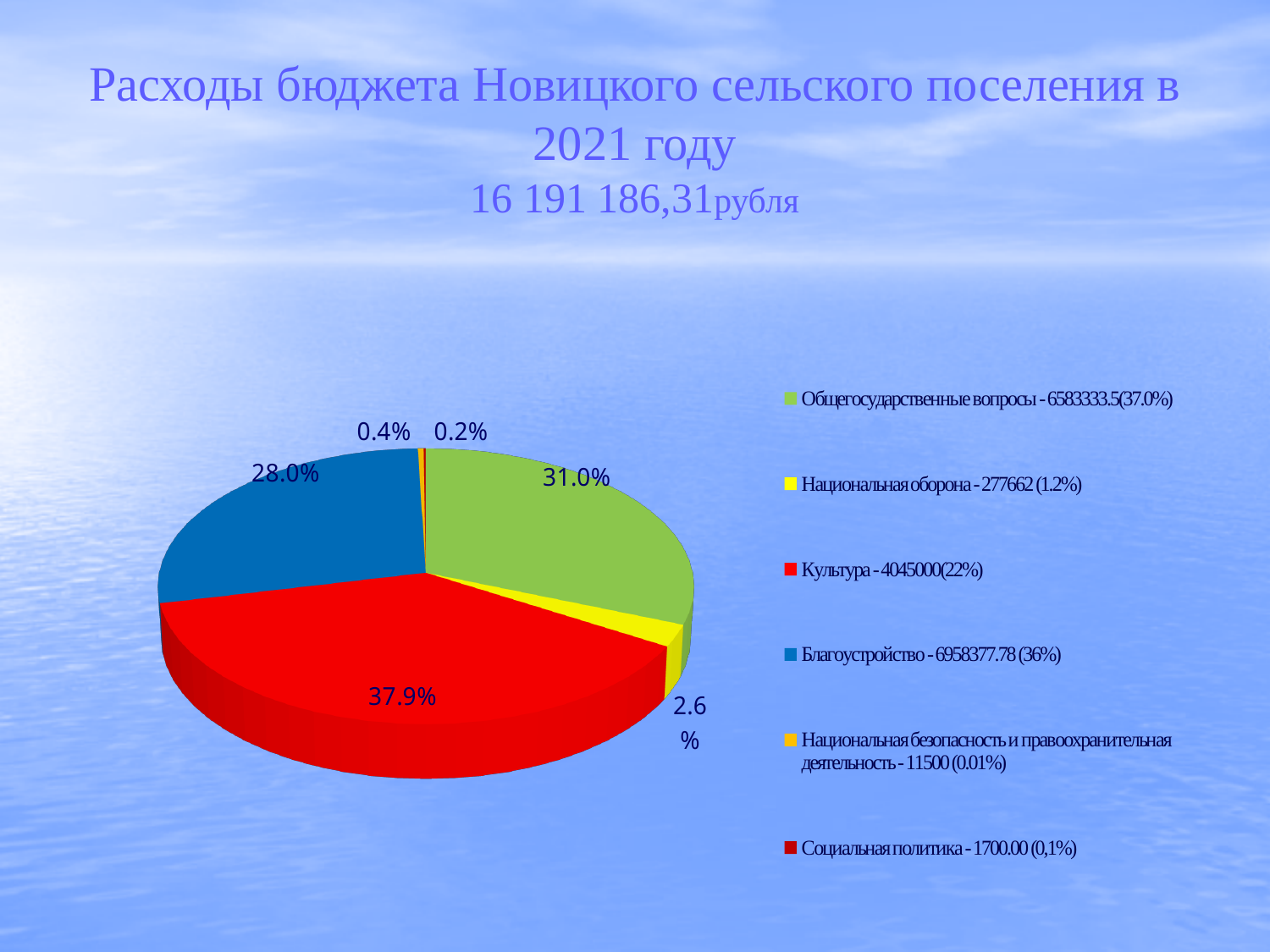
Which category has the largest slice of the pie? Культура What percentage label is shown on the slice for Национальная оборона (yellow)? 2.6% How many categories does the legend list? 6 Which slice is larger: Общегосударственные вопросы or Благоустройство? Общегосударственные вопросы What percentage label is shown on the slice for Культура (red)? 37.9% What total amount in rubles is stated in the slide title? 16 191 186,31 What percentage label is shown on the slice for Благоустройство (blue)? 28.0% What kind of chart is shown on the slide? pie chart What percentage label is shown on the slice for Общегосударственные вопросы (green)? 31.0% Which category has the smallest slice of the pie? Социальная политика By how many percentage points does the Культура slice label exceed the Общегосударственные вопросы slice label? 6.9 What percentage label is shown on the slice for Социальная политика? 0.2%